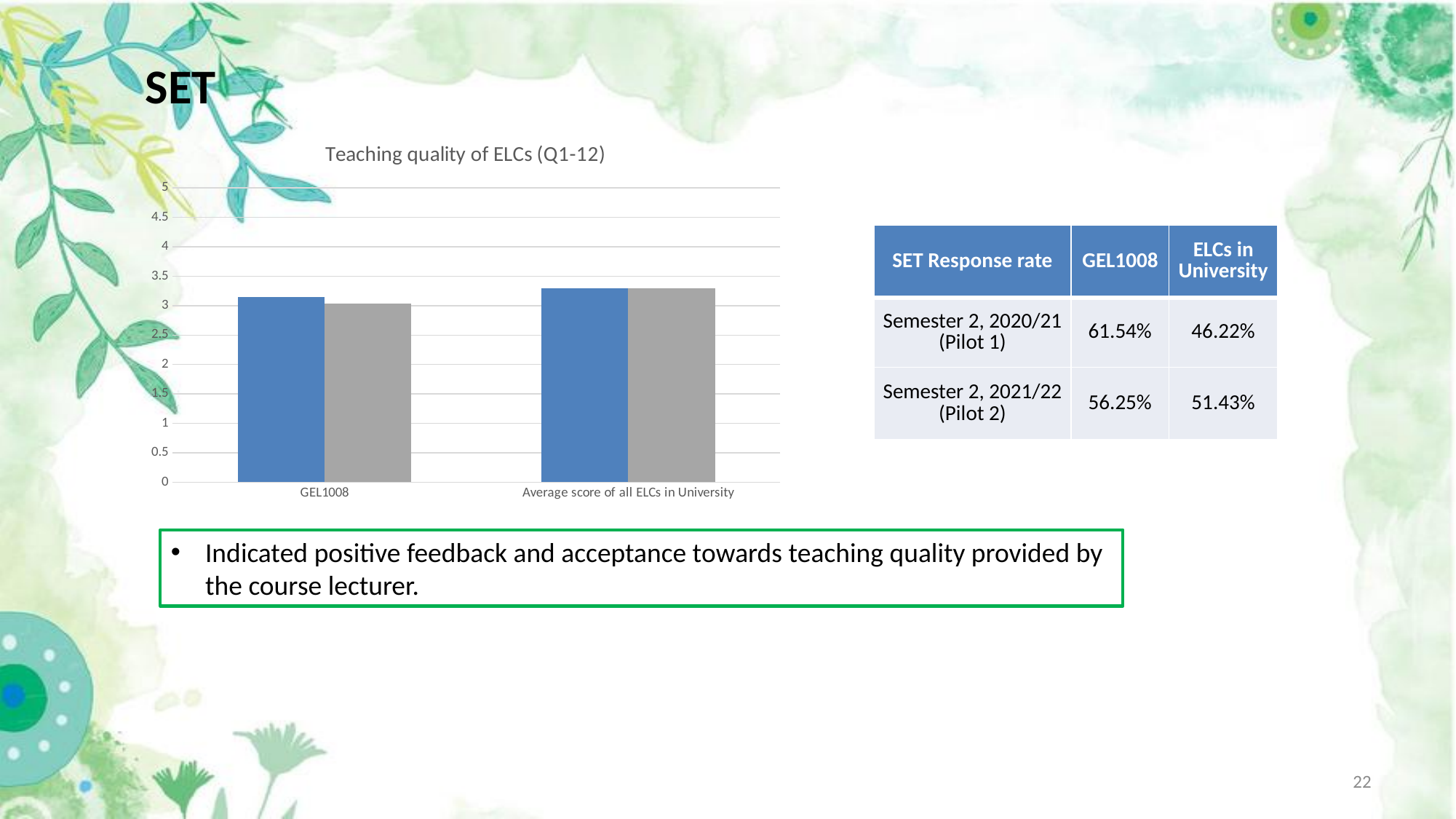
Is the value of the grey bar for Average score of all ELCs in University greater or less than 3? greater Is the value of the blue bar for GEL1008 greater or less than 3? greater Are all the bars in the chart below 4? yes How many categories are shown on the x axis of the chart? 2 What kind of chart is shown on the slide? bar chart What is the highest value shown on the y axis of the chart? 5 What are the two categories on the x axis of the chart? GEL1008 and Average score of all ELCs in University What is the title of the chart? Teaching quality of ELCs (Q1-12) Which category has the taller grey bar, GEL1008 or Average score of all ELCs in University? Average score of all ELCs in University